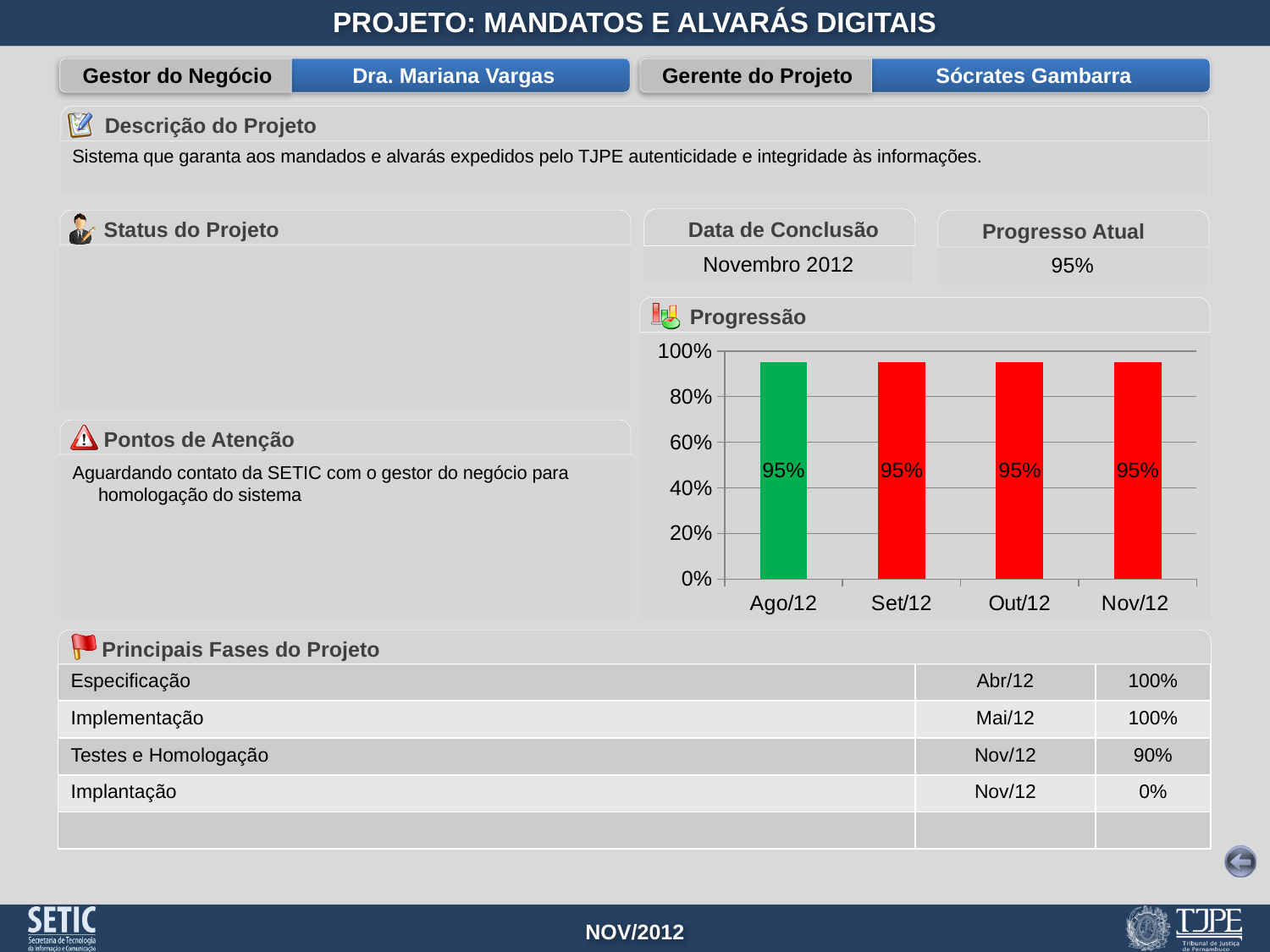
What colour is the Ago/12 bar in the Progressão chart? green Is the value for Out/12 in the Progressão chart greater or less than 80%? greater Is the value for Set/12 in the Progressão chart greater or less than 100%? less How many months are shown on the x axis of the Progressão chart? 4 What is the value for Out/12 in the Progressão chart? 95% What is the title of the bar chart on the slide? Progressão What is the value for Nov/12 in the Progressão chart? 95% What is the value for Ago/12 in the Progressão chart? 95% What is the difference between the values for Nov/12 and Ago/12 in the Progressão chart? 0% Do the values in the Progressão chart rise, fall or stay the same from Ago/12 to Nov/12? stay the same What kind of chart is the Progressão chart? bar chart What is the value for Set/12 in the Progressão chart? 95%